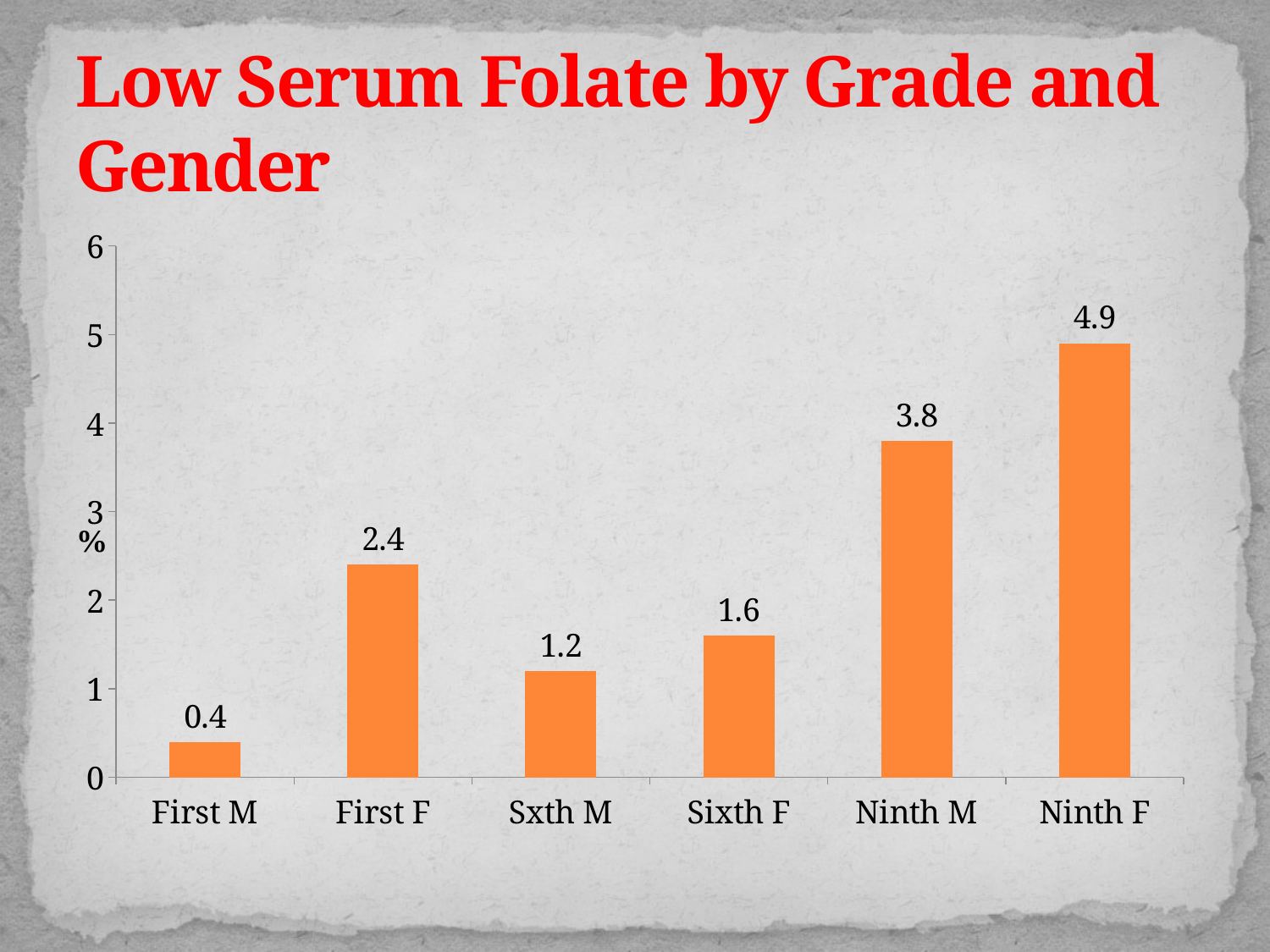
What is the title of the chart? Low Serum Folate by Grade and Gender Which is larger, the value for First F or the value for Sixth F? First F What is the difference between the values for Ninth F and Ninth M? 1.1 Which category has the lowest value? First M Is the value for Sxth M greater or less than 1? greater Which category has the highest value? Ninth F What is the difference between the values for First F and First M? 2.0 What is the value for Sixth F? 1.6 What is the value for First M? 0.4 What is the value for Ninth M? 3.8 How many categories are shown on the x axis? 6 What kind of chart is shown on the slide? bar chart